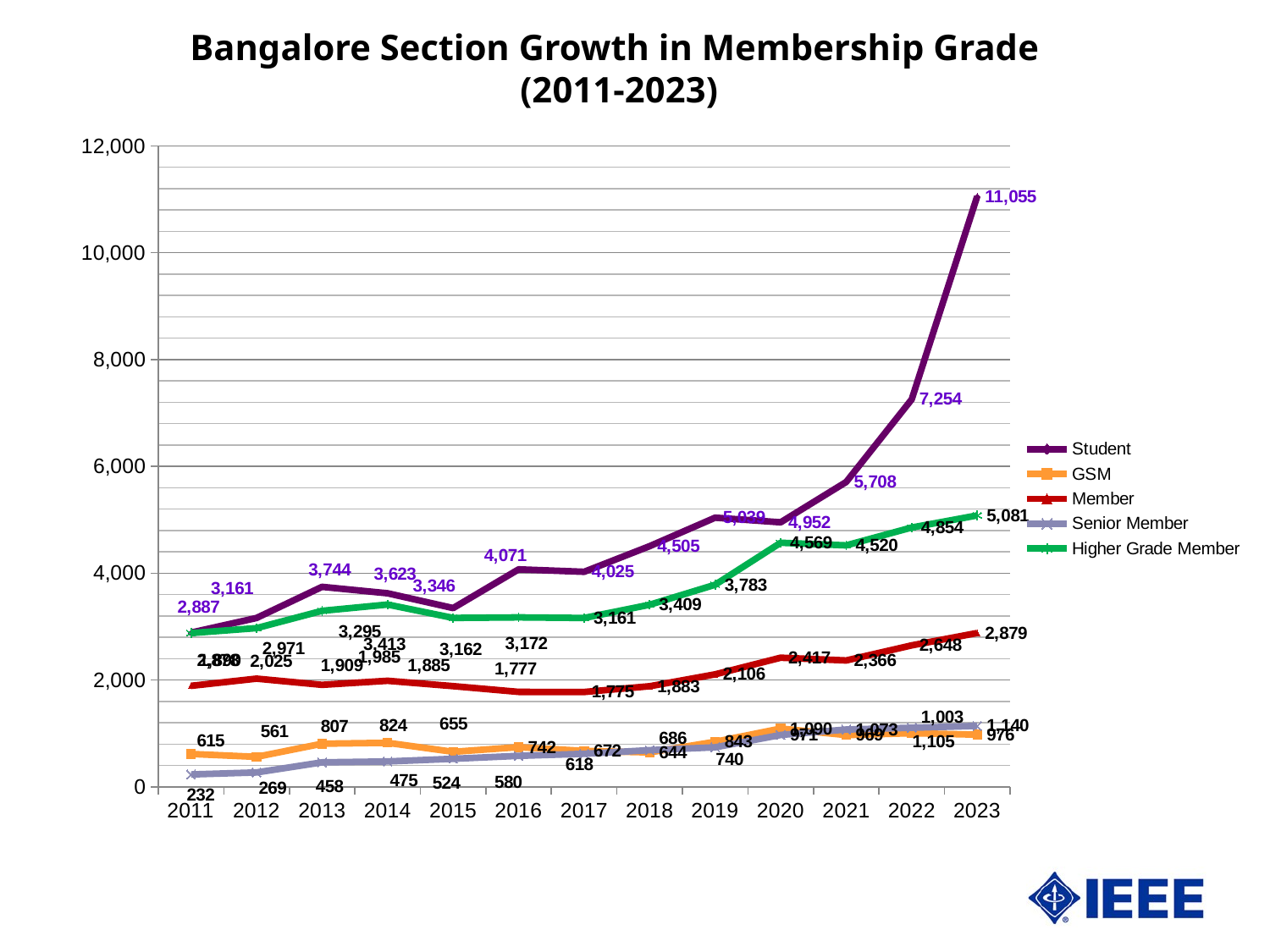
What kind of chart is shown on the slide? Line chart What is the value for Member in 2023? 2,879 What is the difference between the Student values in 2023 and 2022? 3,801 How many series does the legend list? 5 What is the value for Senior Member in 2011? 232 What is the value for Student in 2023? 11,055 What is the value for GSM in 2011? 615 Which is larger in 2023, Student or Higher Grade Member? Student In which year is the Student series highest? 2023 What is the value for Student in 2022? 7,254 What is the value for Higher Grade Member in 2023? 5,081 In which year is the Senior Member series lowest? 2011